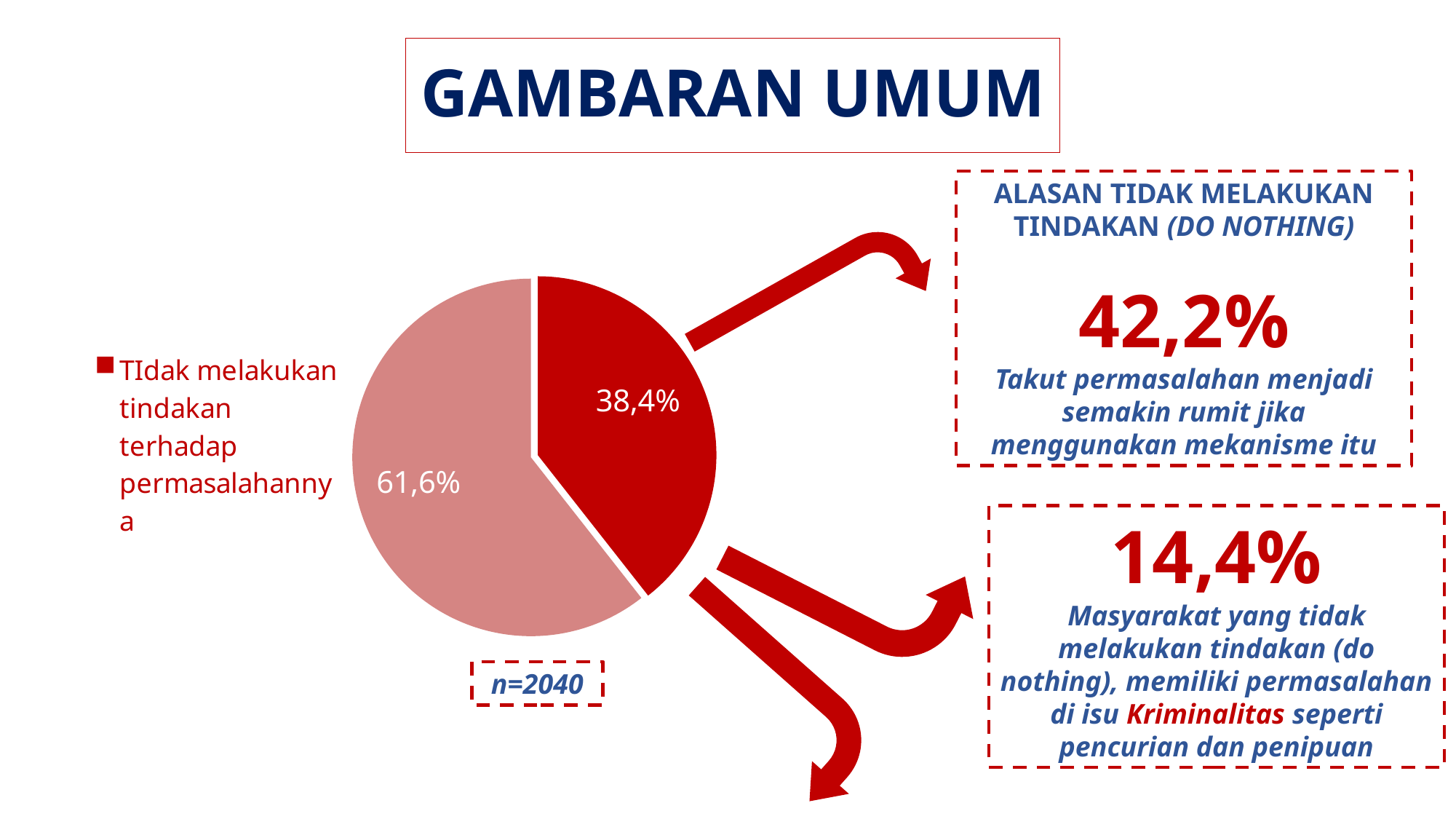
What sample size (n) is shown below the pie chart? n=2040 What percentage is shown on the light pink slice of the pie chart? 61,6% What share of the pie does the dark red slice represent? 38,4% Is the slice for "TIdak melakukan tindakan terhadap permasalahannya" larger or smaller than the other slice? smaller Which slice of the pie chart is the largest? the light pink slice (61,6%) What is the difference in percentage points between the two slices of the pie chart? 23,2 Which slice of the pie chart is the smallest? TIdak melakukan tindakan terhadap permasalahannya (38,4%) What is the title of the slide containing the pie chart? GAMBARAN UMUM What kind of chart is shown on the slide? pie chart How many slices does the pie chart have? 2 What percentage is shown for the slice labelled "TIdak melakukan tindakan terhadap permasalahannya"? 38,4% How many entries does the legend of the pie chart list? 1